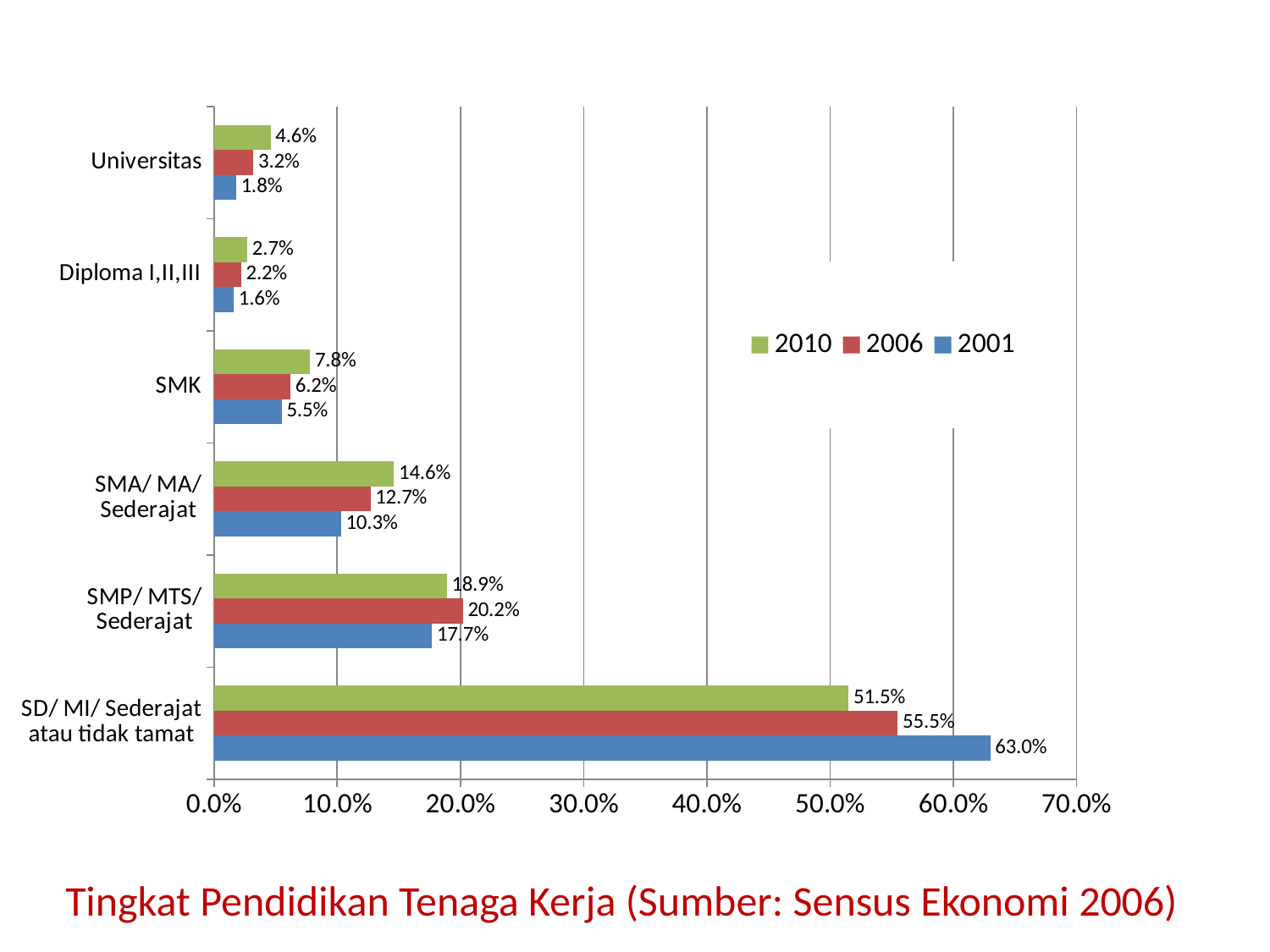
What is the value for Universitas in the 2010 series? 4.6% How many education categories are shown on the chart? 6 How many series does the legend list? 3 What is the difference between the 2001 and 2010 values for SD/ MI/ Sederajat atau tidak tamat? 11.5% What is the value for SD/ MI/ Sederajat atau tidak tamat in the 2001 series? 63.0% What kind of chart is shown on the slide? Bar chart What is the value for SMP/ MTS/ Sederajat in the 2006 series? 20.2% Which series is shown in green in the legend? 2010 Is the 2006 value for SD/ MI/ Sederajat atau tidak tamat greater or less than 50.0%? greater Which is larger for SMA/ MA/ Sederajat: the 2010 value or the 2001 value? 2010 Which category has the lowest value in the 2001 series? Diploma I,II,III Which category has the highest value in the 2010 series? SD/ MI/ Sederajat atau tidak tamat